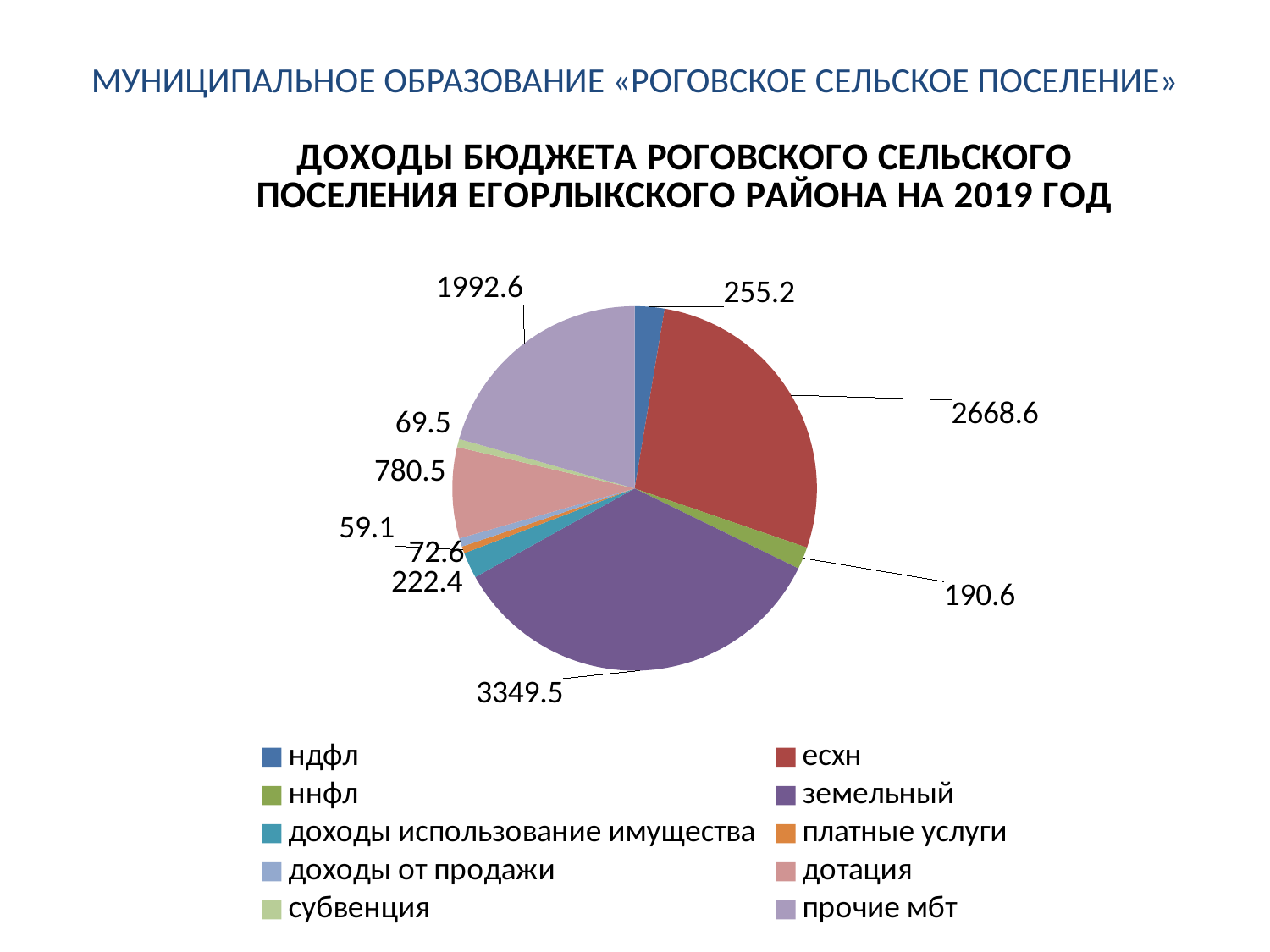
What is the value for платные услуги? 59.1 What is the title of the chart? ДОХОДЫ БЮДЖЕТА РОГОВСКОГО СЕЛЬСКОГО ПОСЕЛЕНИЯ ЕГОРЛЫКСКОГО РАЙОНА НА 2019 ГОД What is the value for есхн? 2668.6 Which is larger, the value for прочие мбт or the value for дотация? прочие мбт How many categories does the pie chart have? 10 What is the value for земельный? 3349.5 Which category has the largest slice of the pie? земельный Which category has the smallest slice of the pie? платные услуги What type of chart is shown on the slide? pie chart What is the value for прочие мбт? 1992.6 What is the difference between the values for земельный and есхн? 680.9 What is the value for дотация? 780.5